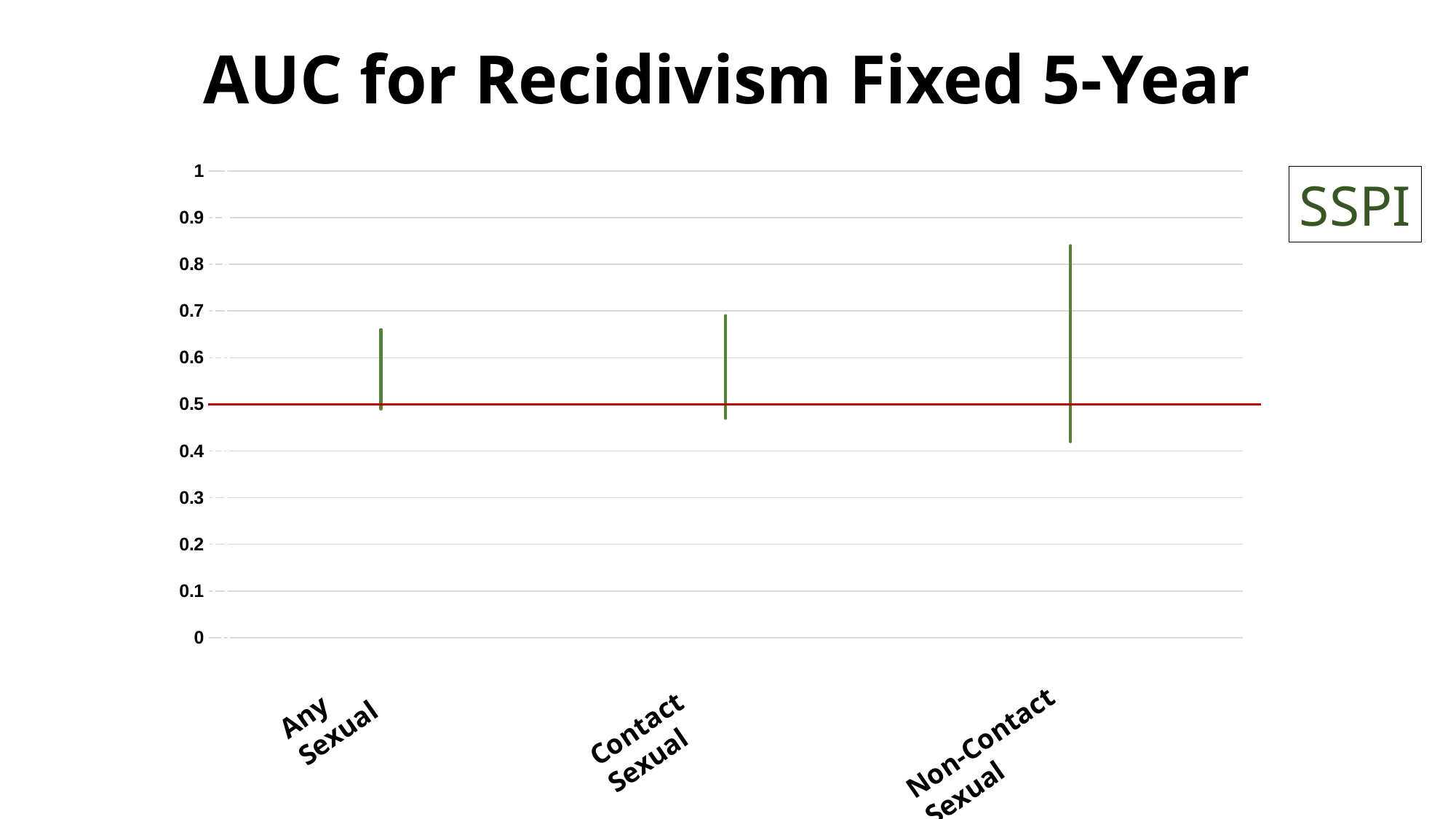
Which category has the highest upper end of its range? Non-Contact Sexual Is the lower end of the range for Non-Contact Sexual greater or less than 0.5? less Is the upper end of the range for Non-Contact Sexual greater or less than 0.8? greater How many categories are shown on the x axis of the chart? 3 What is the maximum value shown on the y axis? 1 What is the title of the chart? AUC for Recidivism Fixed 5-Year Which category has the lowest lower end of its range? Non-Contact Sexual Which has the higher upper end of its range, Any Sexual or Non-Contact Sexual? Non-Contact Sexual At what value on the y axis is the red horizontal line drawn? 0.5 Is the upper end of the range for Any Sexual greater or less than 0.6? greater